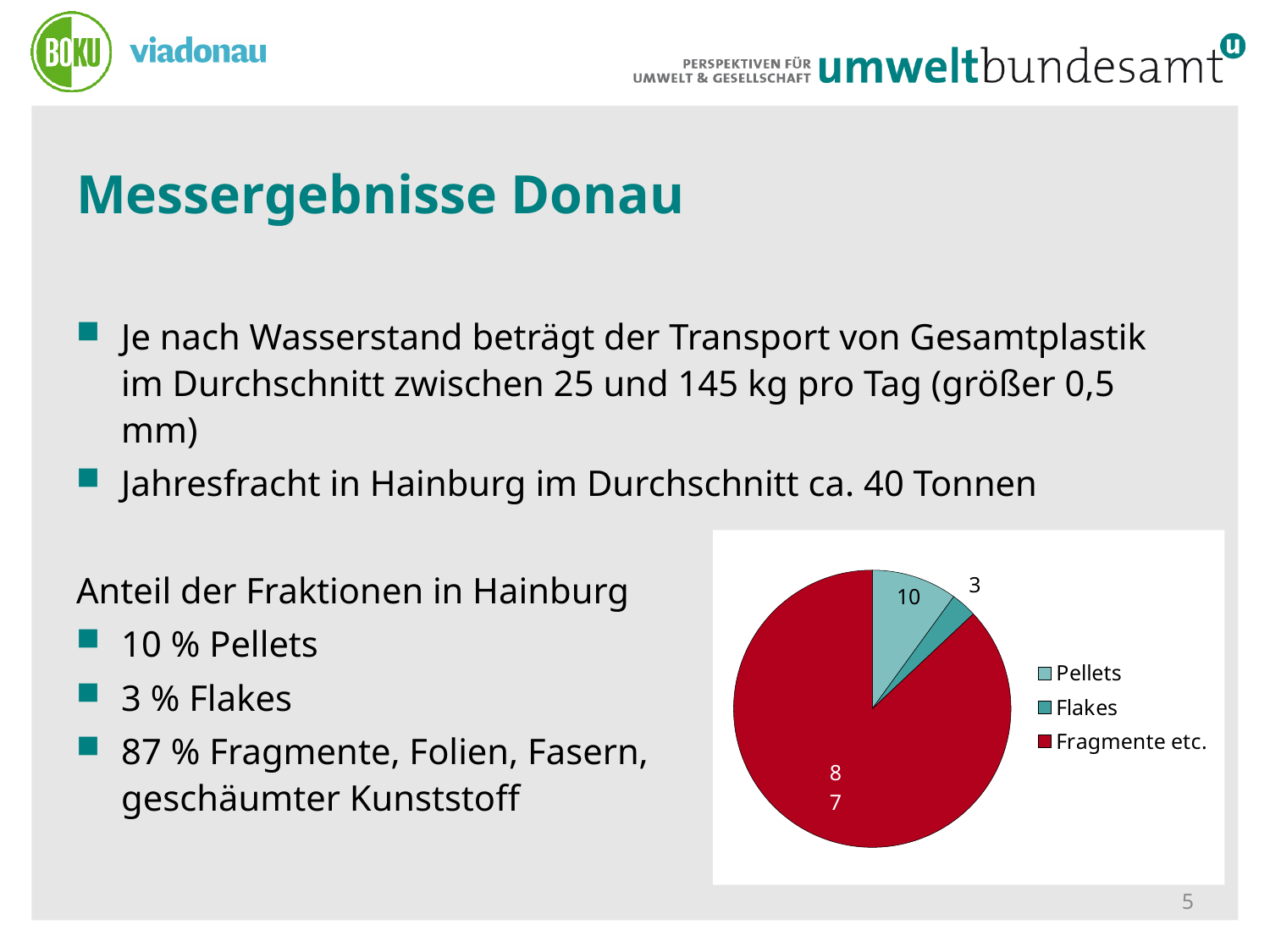
How many slices does the pie chart have? 3 What is the value shown for Pellets in the pie chart? 10 Which category has the smallest slice in the pie chart? Flakes What is the difference between the values for Pellets and Flakes in the pie chart? 7 What is the value shown for Fragmente etc. in the pie chart? 87 Which category has the largest slice in the pie chart? Fragmente etc. What is the difference between the values for Fragmente etc. and Pellets in the pie chart? 77 Which is larger in the pie chart, Pellets or Flakes? Pellets What colour is the Fragmente etc. slice in the pie chart? red How many entries does the legend of the pie chart list? 3 What is the value shown for Flakes in the pie chart? 3 What kind of chart is shown on the slide? pie chart